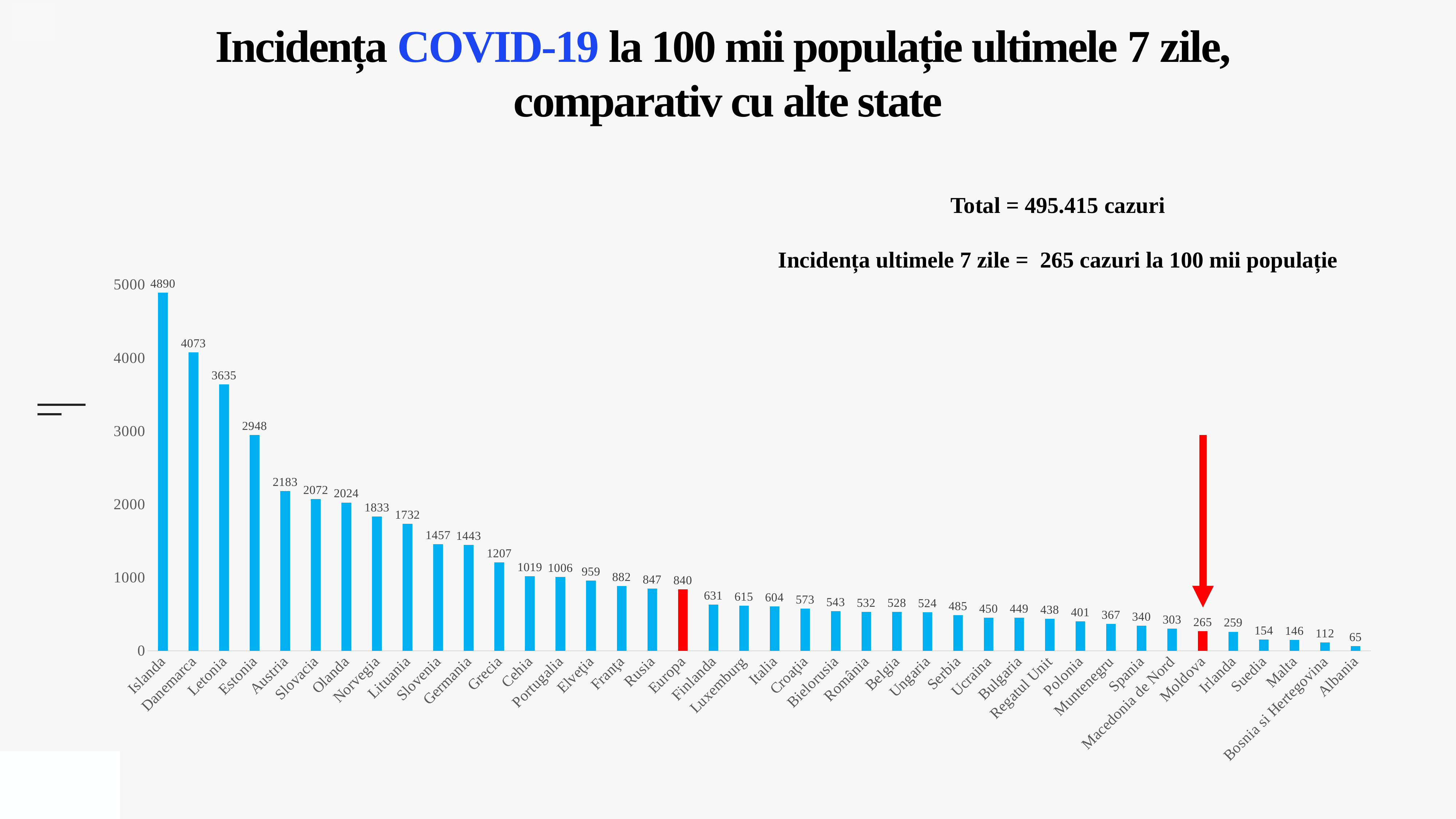
Which country has the highest value? Islanda What kind of chart is shown on the slide? bar chart What is the value for România? 532 Is the value for Letonia greater or less than 3000? greater What is the value for Europa? 840 Which bars are coloured red instead of blue? Europa and Moldova Which country has the lowest value? Albania Which has a larger value, Austria or Grecia? Austria What is the difference between the values for Europa and Moldova? 575 What is the value for Moldova? 265 How many countries/regions are shown on the x axis? 40 What is the difference between the values for Islanda and Danemarca? 817